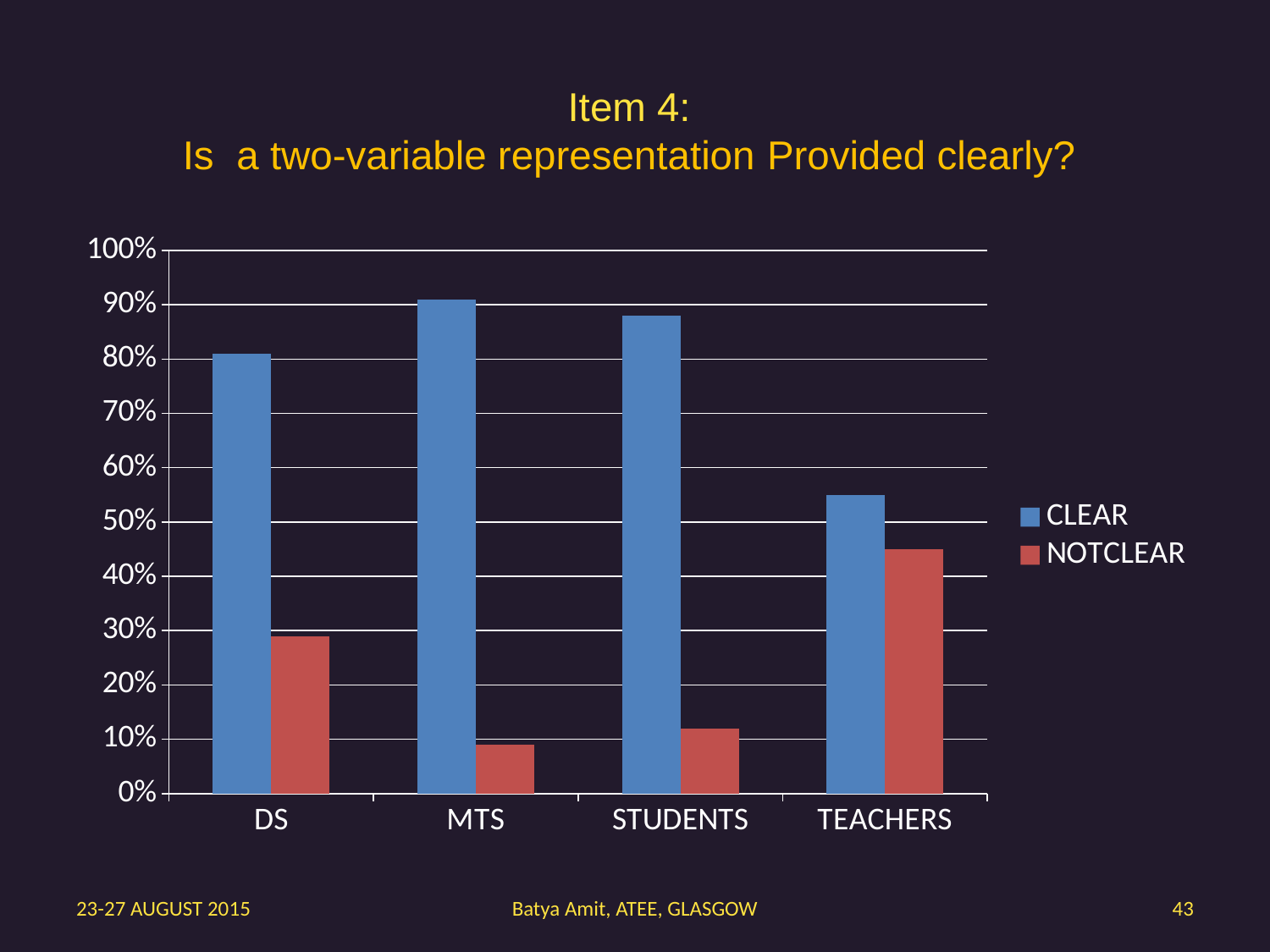
Is the NOTCLEAR value for TEACHERS greater or less than 50%? less Which is larger for STUDENTS, the CLEAR value or the NOTCLEAR value? CLEAR What colour are the NOTCLEAR bars in the chart? red How many categories are shown on the x axis of the chart? 4 How many series does the legend list? 2 Which category has the highest NOTCLEAR value? TEACHERS Is the CLEAR value for DS greater or less than 70%? greater Which category has the highest CLEAR value? MTS Which category has the lowest NOTCLEAR value? MTS What kind of chart is shown on the slide? bar chart Is the CLEAR value for TEACHERS greater or less than 50%? greater Which category has the lowest CLEAR value? TEACHERS